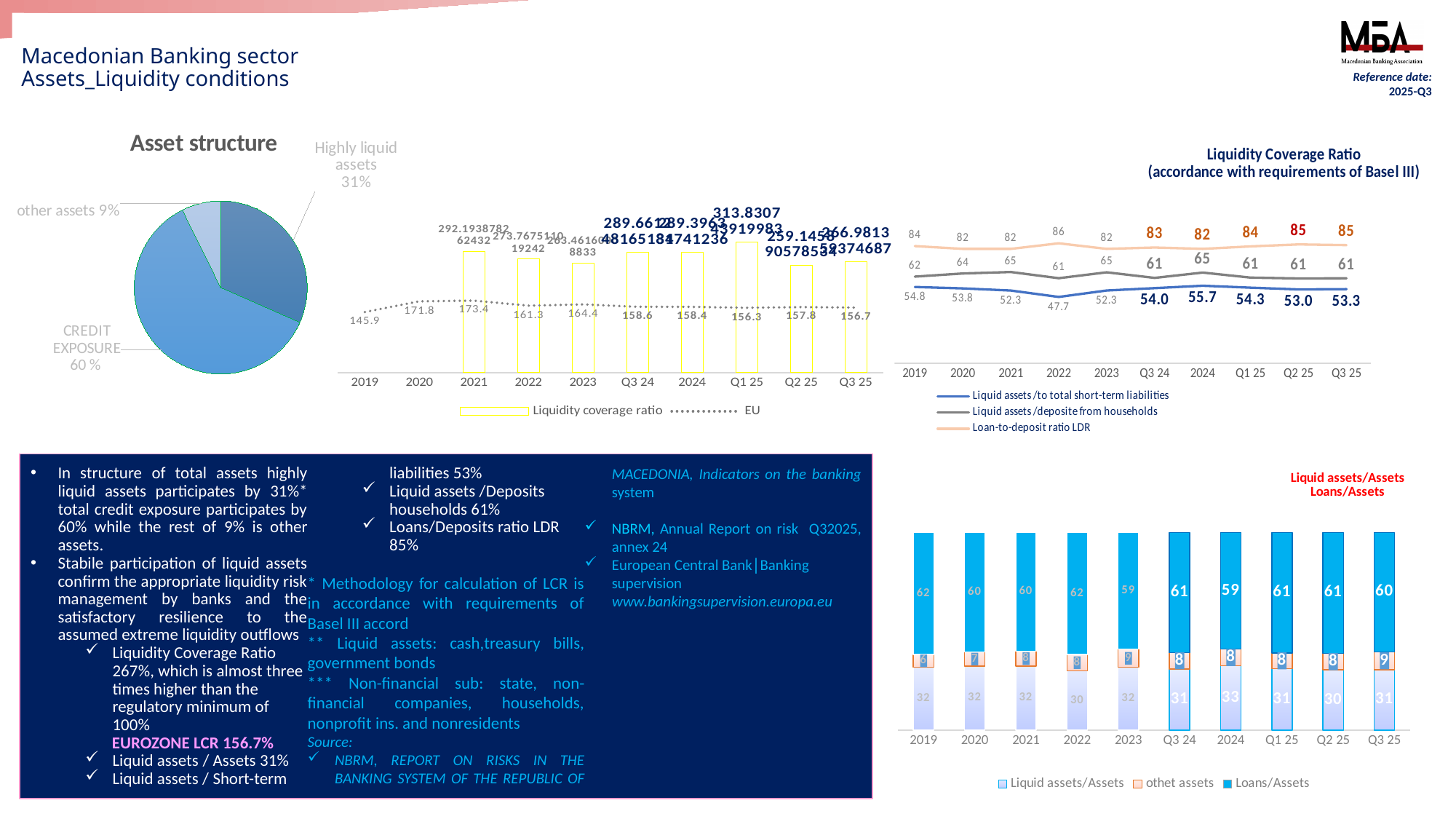
In the Liquidity Coverage Ratio (Basel III) line chart, what is the lowest value of Liquid assets/to total short-term liabilities? 47.7 In the Liquidity coverage ratio chart (middle top), in which year is the EU value highest? 2021 In the Liquid assets/Assets Loans/Assets stacked bar chart, what is the total of the Q3 25 bar? 100 In the Liquidity coverage ratio chart (middle top), what is the EU value for 2019? 145.9 In the Asset structure pie chart, how many slices are there? 3 In the Liquid assets/Assets Loans/Assets stacked bar chart, what is the Loans/Assets value for 2023? 59 In the Asset structure pie chart, what share do highly liquid assets have? 31% What type of chart is the Liquid assets/Assets Loans/Assets chart at the bottom right? Stacked bar chart In the Liquidity Coverage Ratio (Basel III) line chart, how many series does the legend list? 3 In the Asset structure pie chart, which category has the largest share? CREDIT EXPOSURE In the Liquidity coverage ratio chart (middle top), what is the EU value for Q3 25? 156.7 In the Liquidity Coverage Ratio (Basel III) line chart, what is the Loan-to-deposit ratio LDR for Q3 25? 85